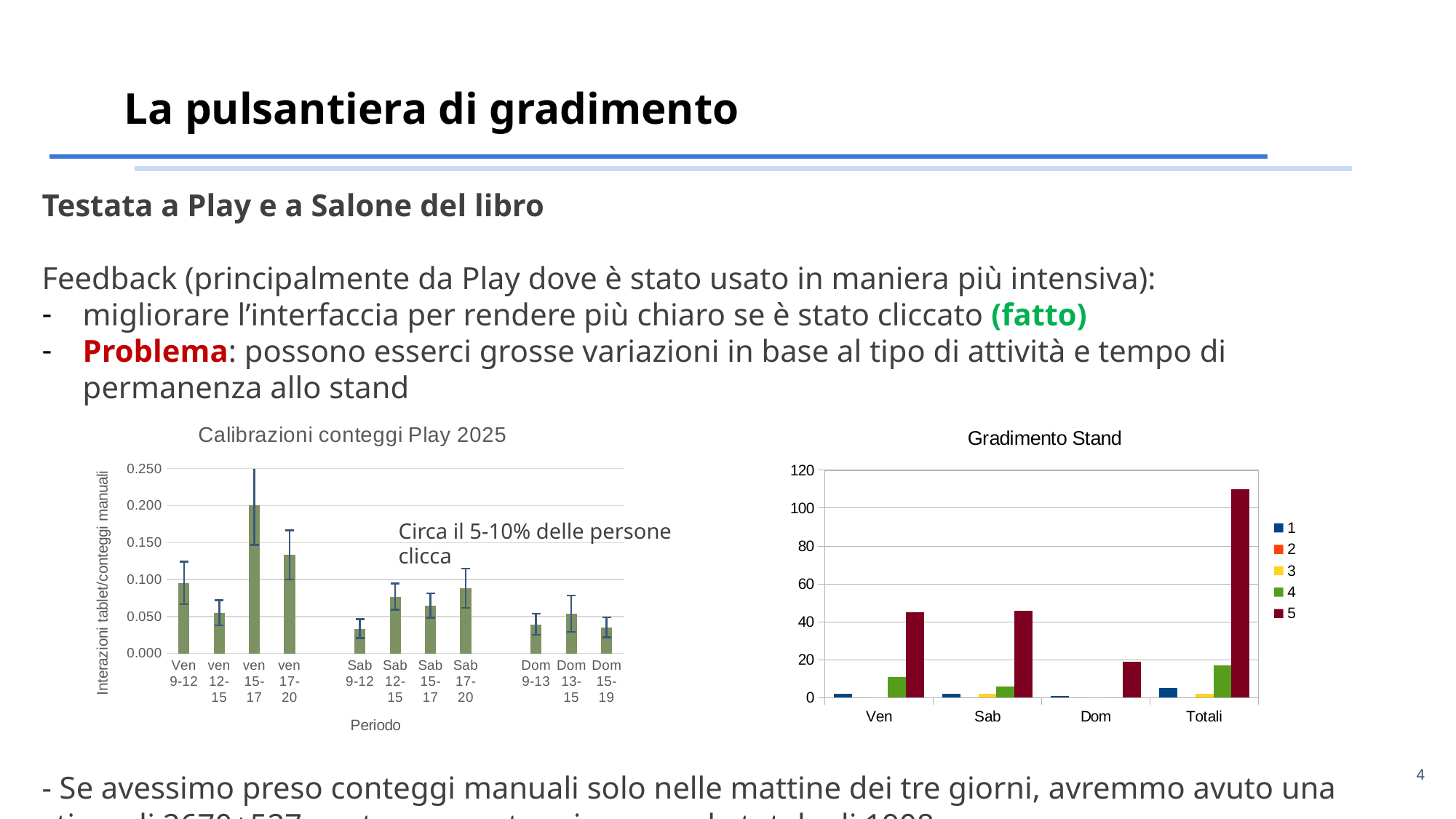
In the 'Gradimento Stand' chart, is the value of series 5 for Dom greater or less than 40? less How many categories are shown on the x axis of the 'Gradimento Stand' chart? 4 In the 'Calibrazioni conteggi Play 2025' chart, which period has the highest value? ven 15-17 In the 'Calibrazioni conteggi Play 2025' chart, which is larger: the value for ven 15-17 or for Sab 12-15? ven 15-17 What is the y-axis label of the 'Calibrazioni conteggi Play 2025' chart? Interazioni tablet/conteggi manuali How many series does the legend of the 'Gradimento Stand' chart list? 5 In the 'Calibrazioni conteggi Play 2025' chart, is the value for ven 15-17 greater or less than 0.150? greater In the 'Calibrazioni conteggi Play 2025' chart, is the value for Sab 9-12 greater or less than 0.050? less In the 'Gradimento Stand' chart, which is larger: the value of series 4 for Ven or for Sab? Ven How many periods are shown on the x axis of the 'Calibrazioni conteggi Play 2025' chart? 11 What type of chart is the 'Calibrazioni conteggi Play 2025' chart? bar chart